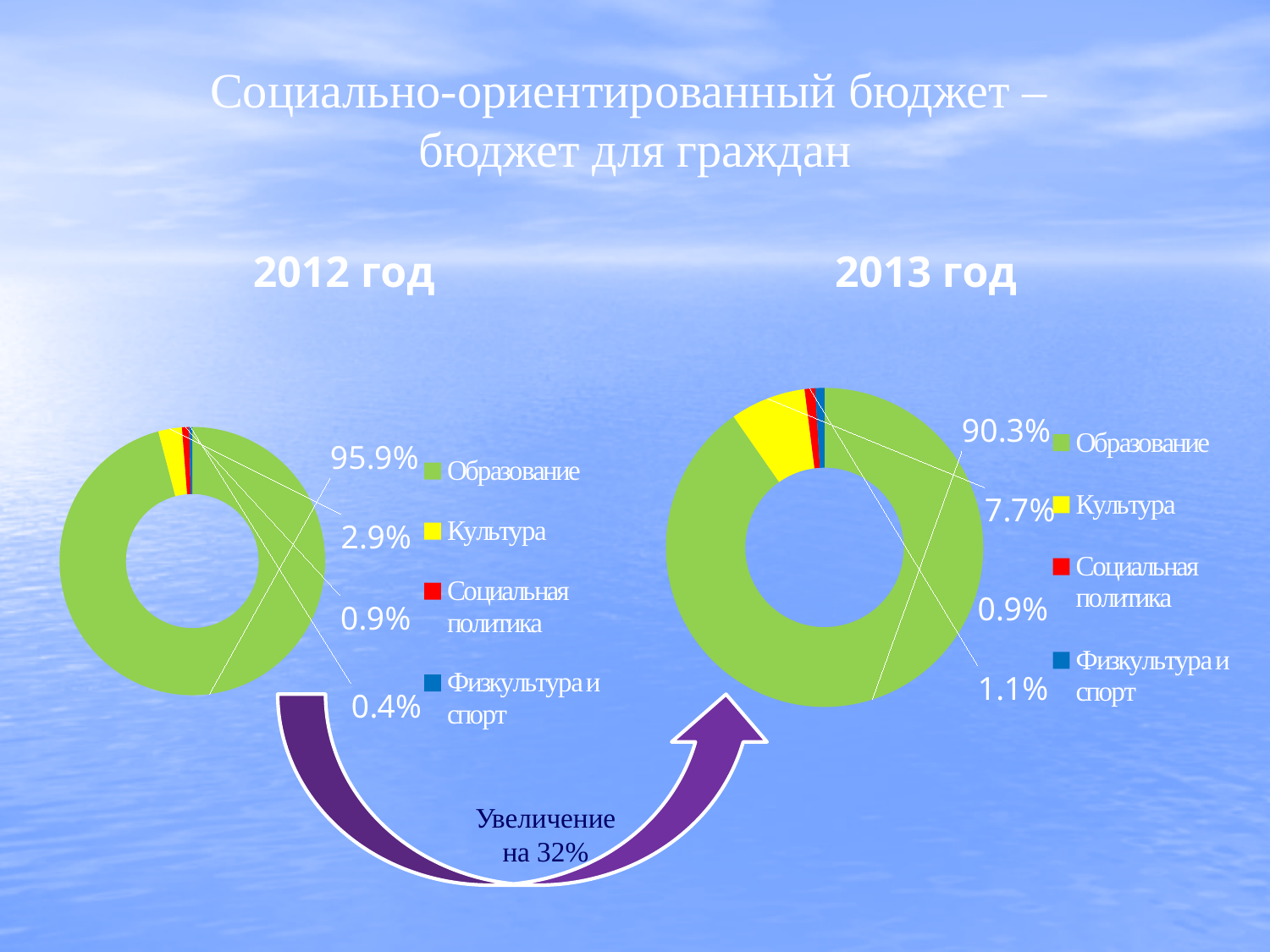
In the 2013 год chart, what share does Культура have? 7.7% In the 2013 год chart, what is the difference between the Культура and Физкультура и спорт shares? 6.8% In the 2012 год chart, what is the value for Физкультура и спорт? 0.4% What is the difference between the Образование share in the 2012 год chart and in the 2013 год chart? 5.6% In the 2012 год chart, what share does Образование have? 95.9% In the 2013 год chart, what is the value for Социальная политика? 1.1% In the 2012 год chart, which category has the smallest share? Физкультура и спорт Which is larger: the Культура share in the 2012 год chart or in the 2013 год chart? 2013 год What type of chart is the 2012 год chart? Doughnut chart How many categories does the legend of the 2013 год chart list? 4 In the 2013 год chart, which category has the largest share? Образование In the 2012 год chart, which colour represents Культура? Yellow